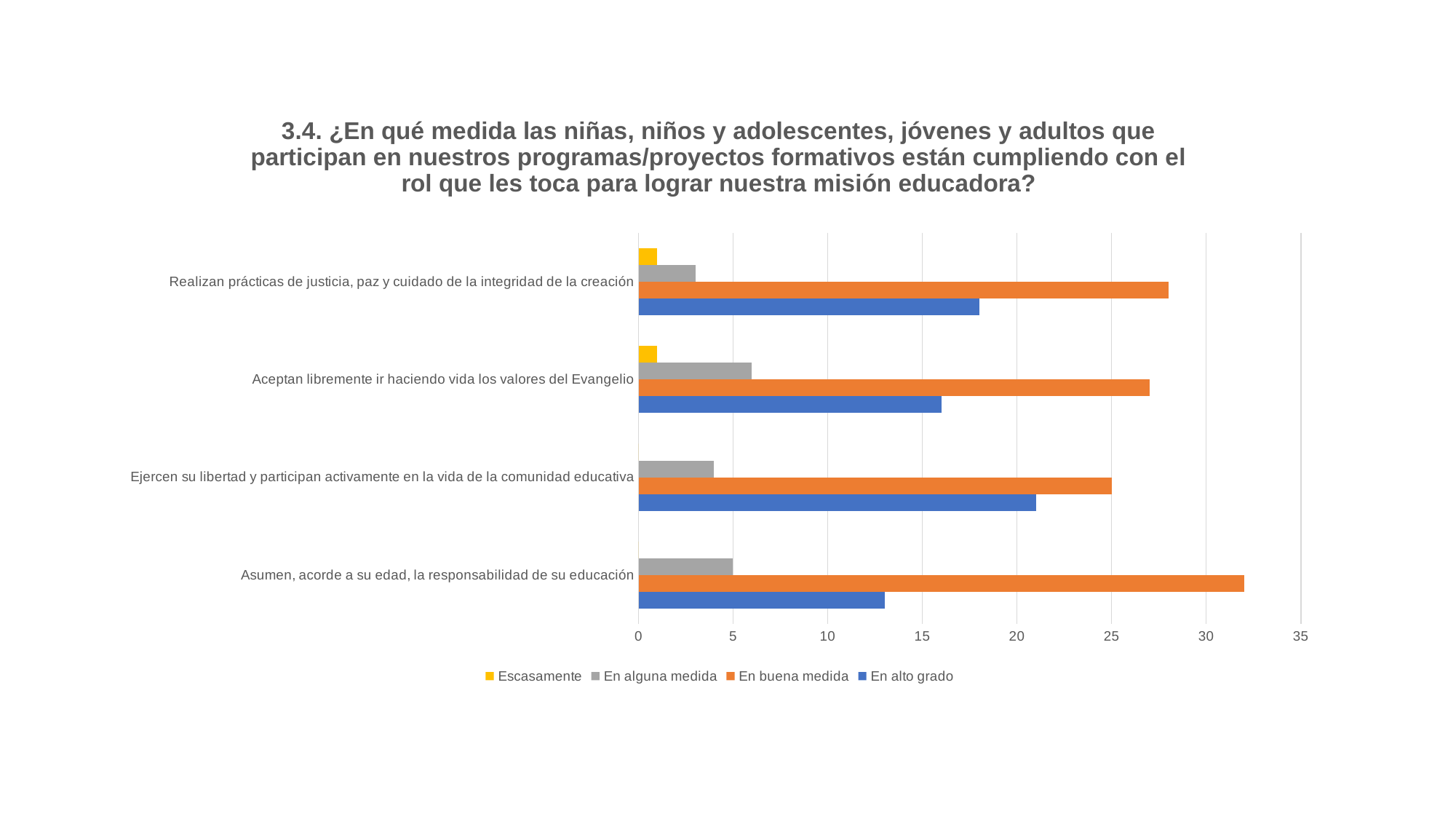
What is the value of 'En alguna medida' for 'Asumen, acorde a su edad, la responsabilidad de su educación'? 5 Which category has the highest value for 'En buena medida'? Asumen, acorde a su edad, la responsabilidad de su educación For 'Aceptan libremente ir haciendo vida los valores del Evangelio', which is larger: 'En buena medida' or 'En alto grado'? En buena medida What kind of chart is shown on the slide? bar chart What is the value of 'En buena medida' for 'Ejercen su libertad y participan activamente en la vida de la comunidad educativa'? 25 Is the value of 'En alto grado' for 'Asumen, acorde a su edad, la responsabilidad de su educación' greater or less than 15? less How many series does the legend list? 4 How many categories are plotted on the chart? 4 Which category has the highest value for 'En alto grado'? Ejercen su libertad y participan activamente en la vida de la comunidad educativa Is the value of 'En buena medida' for 'Asumen, acorde a su edad, la responsabilidad de su educación' greater or less than 30? greater Is the value of 'En alto grado' for 'Ejercen su libertad y participan activamente en la vida de la comunidad educativa' greater or less than 20? greater Which colour represents the 'Escasamente' series in the legend? yellow